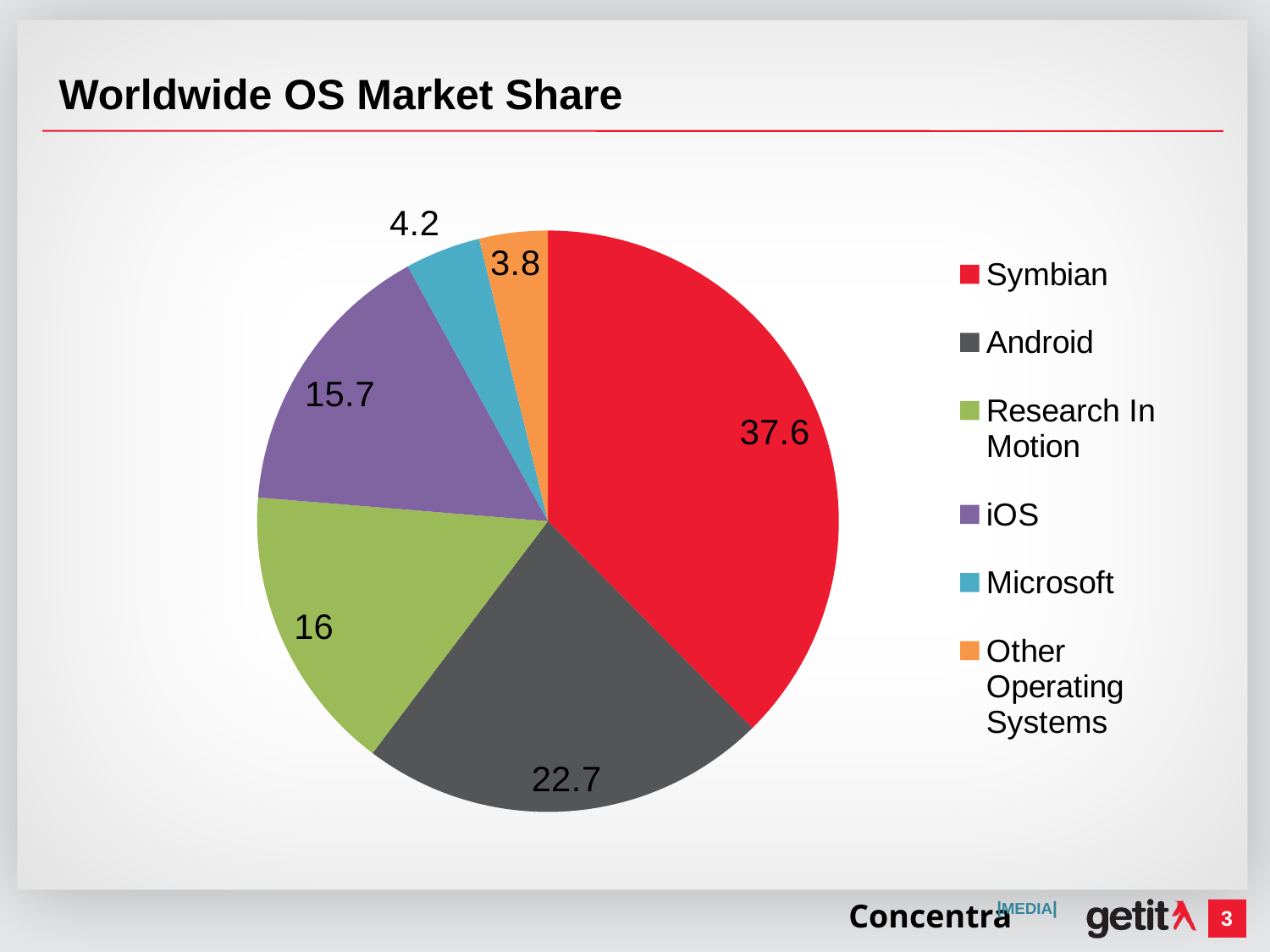
What is the title of the chart? Worldwide OS Market Share What is the value for Microsoft? 4.2 How many categories does the legend list? 6 Which operating system has the largest slice of the pie? Symbian Which category has the smallest slice of the pie? Other Operating Systems What is the value for Symbian? 37.6 What is the value for Android? 22.7 What is the value for Other Operating Systems? 3.8 What is the value for Research In Motion? 16 What type of chart is shown on the slide? pie chart What is the value for iOS? 15.7 What is the difference between the values for Symbian and Android? 14.9